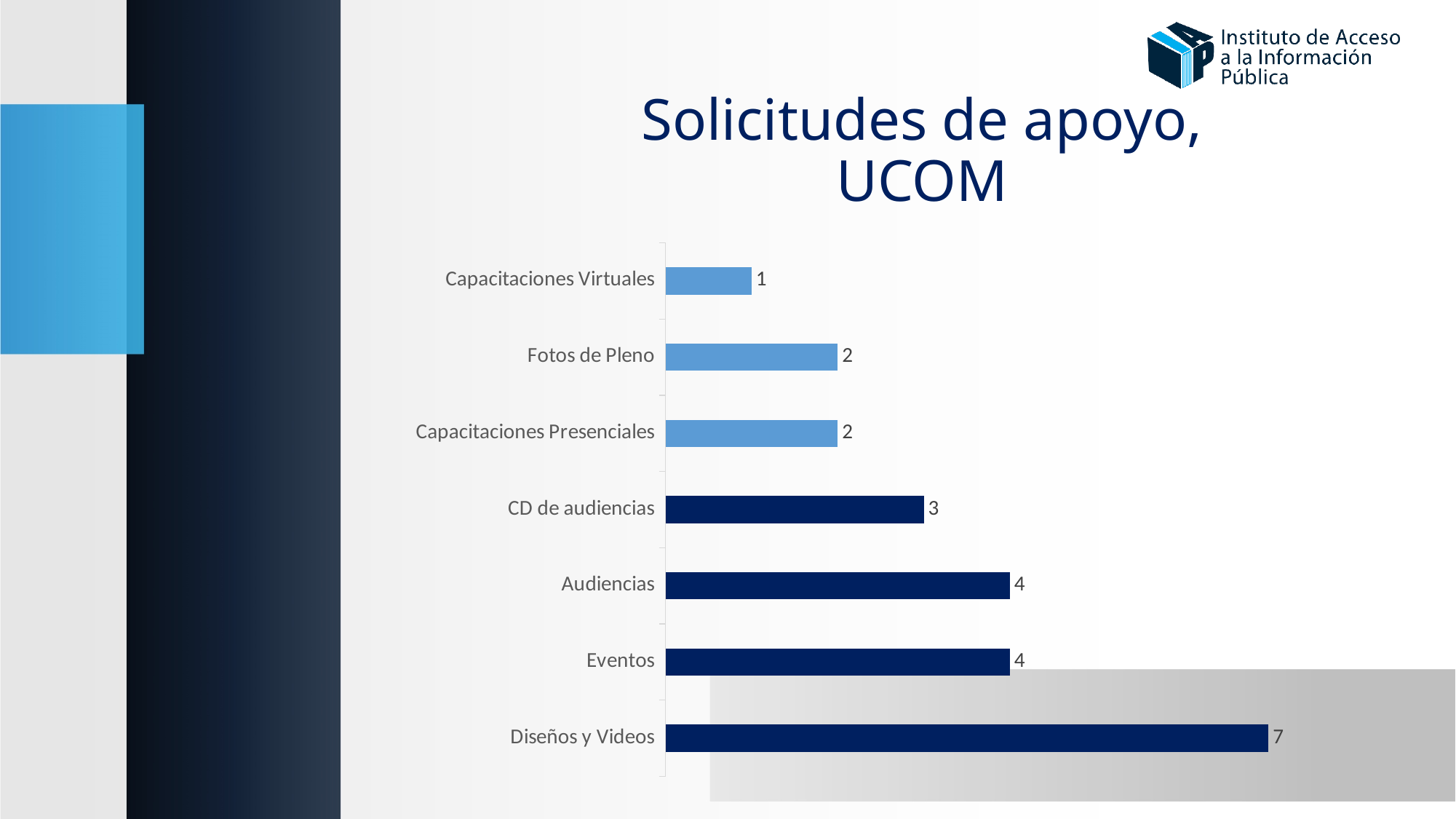
What kind of chart is shown on the slide? Bar chart Which is larger, the value for CD de audiencias or the value for Fotos de Pleno? CD de audiencias What is the value for Fotos de Pleno? 2 Which category has the lowest value? Capacitaciones Virtuales What is the title of the slide? Solicitudes de apoyo, UCOM What is the difference between the values for Audiencias and Capacitaciones Presenciales? 2 Which category has the highest value? Diseños y Videos What is the value for Diseños y Videos? 7 What is the value for CD de audiencias? 3 How many categories are shown in the chart? 7 What is the difference between the values for Diseños y Videos and Eventos? 3 What is the value for Capacitaciones Virtuales? 1